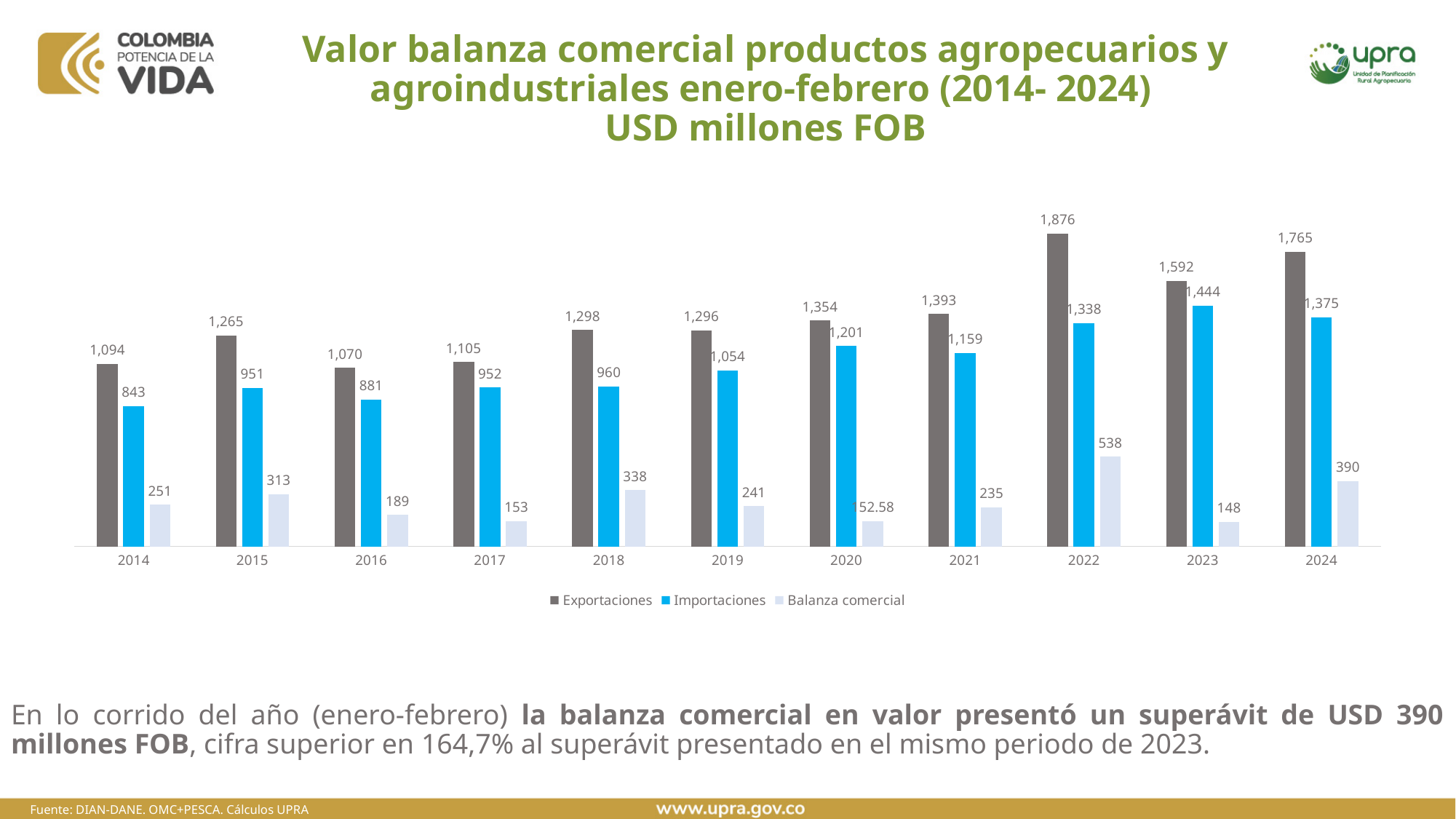
How many years are shown on the x axis? 11 What was the value of Exportaciones in 2022? 1,876 What kind of chart is shown on the slide? Bar chart Which year had the lowest Balanza comercial value? 2023 What is the difference between Exportaciones and Importaciones in 2024? 390 Did the Balanza comercial rise or fall from 2022 to 2023? Fall Which year had the highest Exportaciones value? 2022 How many series does the legend list? 3 Which was larger in 2016, Exportaciones or Importaciones? Exportaciones What was the value of Importaciones in 2019? 1,054 What was the Balanza comercial in 2020? 152.58